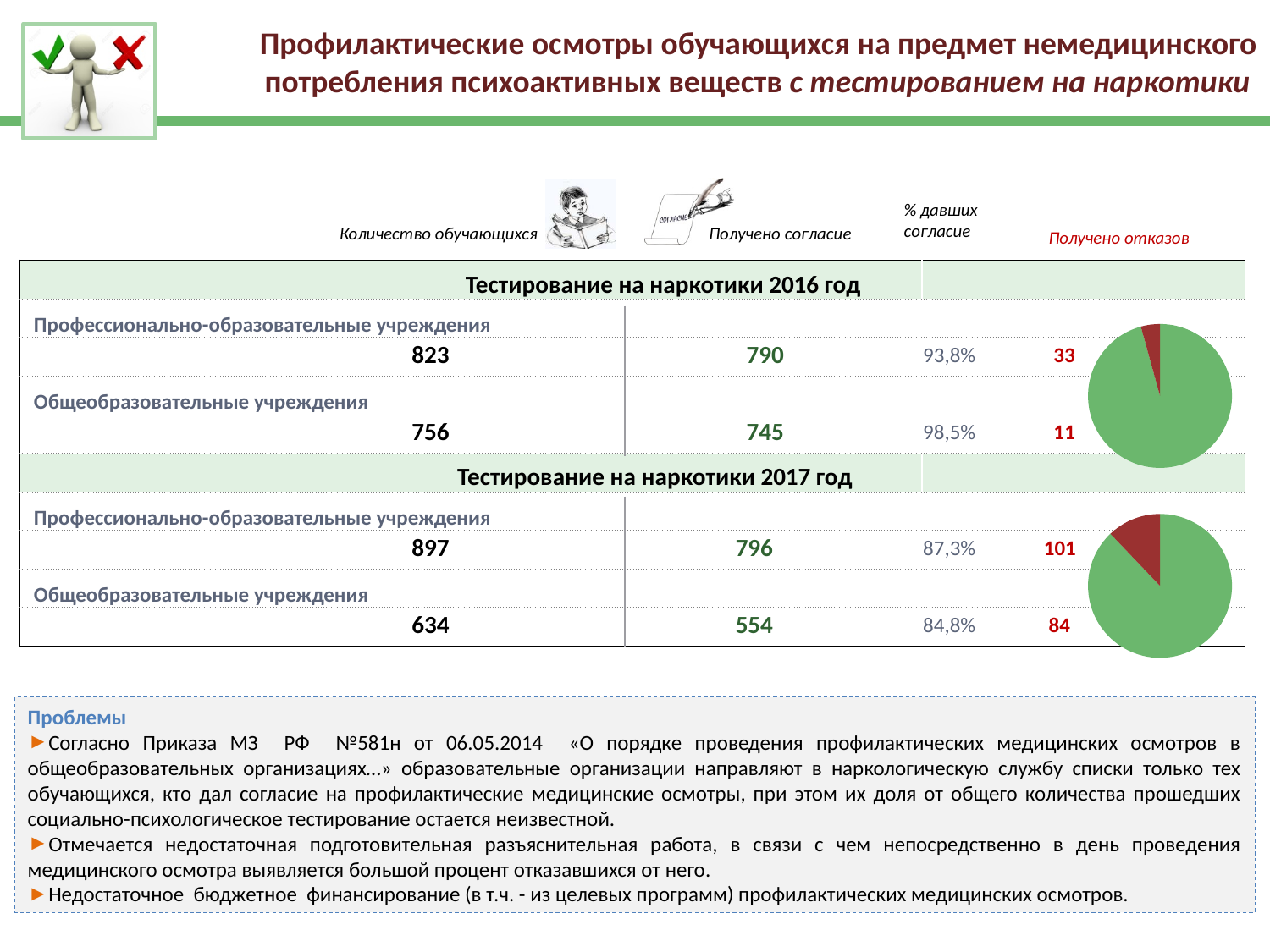
What kind of chart is shown next to the 2017 drug-testing rows? pie chart What colour is the larger slice in both pie charts? green In the 2017 pie chart, which slice is larger, the green one or the dark red one? green Which pie chart has the larger dark red slice, the 2016 one or the 2017 one? 2017 How many slices does the 2016 pie chart have? 2 What kind of chart is shown next to the 2016 drug-testing rows? pie chart Across both years in the table, which row has the lowest percentage of consent (% давших согласие)? Общеобразовательные учреждения, 2017 (84,8%) What is the difference between the number of students in Профессионально-образовательные учреждения in 2017 and in 2016? 74 In the 2016 table, what is the percentage of consent (% давших согласие) for Общеобразовательные учреждения? 98,5% In the 2017 table, how many consents (Получено согласие) are listed for Общеобразовательные учреждения? 554 In the 2016 table, how many students (Количество обучающихся) are listed for Профессионально-образовательные учреждения? 823 In the 2017 table, how many refusals (Получено отказов) are listed for Профессионально-образовательные учреждения? 101